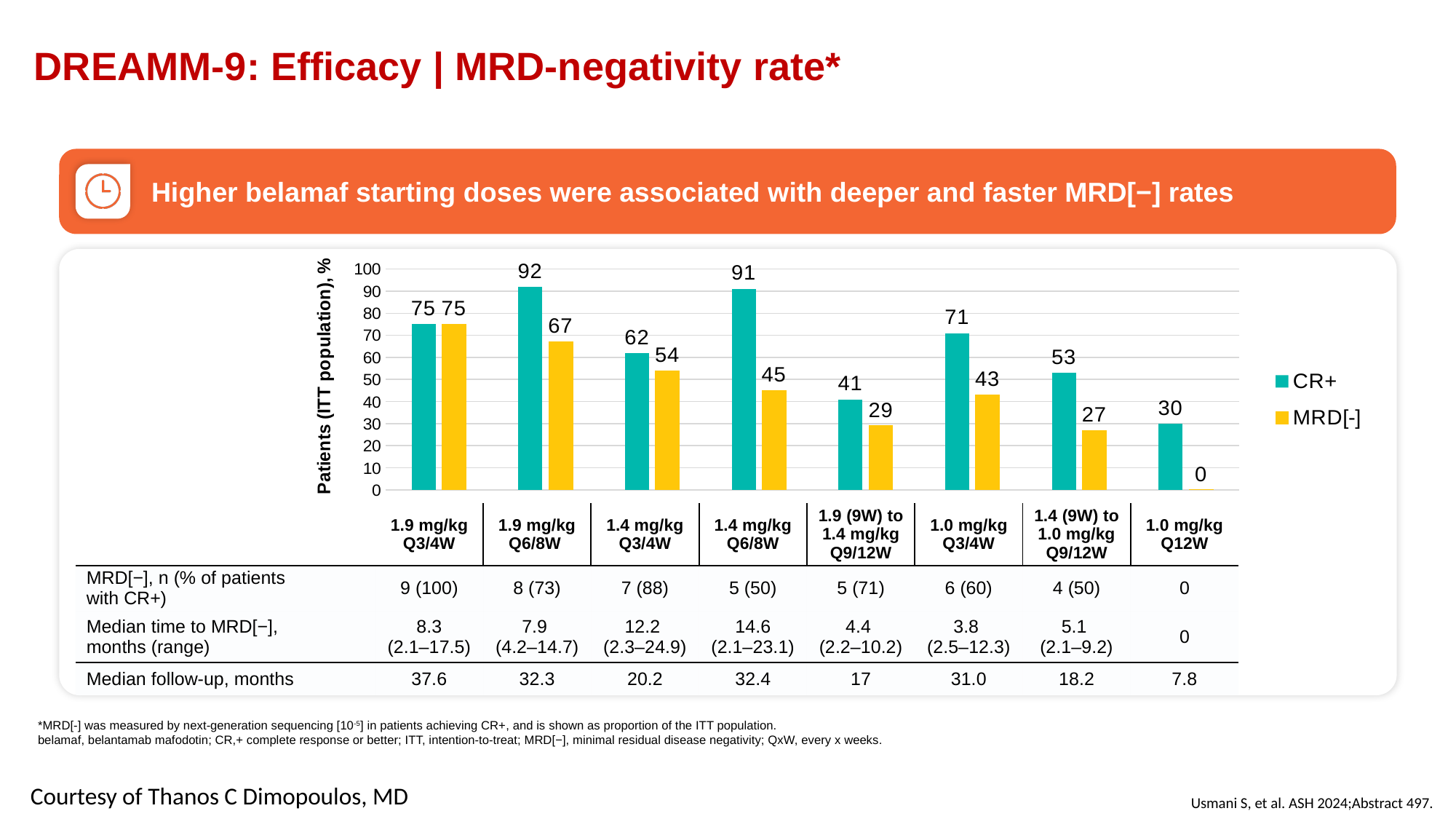
Which dose group has the lowest MRD[-] value? 1.0 mg/kg Q12W Which dose group has the highest CR+ value? 1.9 mg/kg Q6/8W What is the difference between the CR+ and MRD[-] values for the 1.4 mg/kg Q6/8W group? 46 How many dose groups are shown on the x axis of the chart? 8 What is the CR+ value for the 1.9 mg/kg Q6/8W group? 92 What is the MRD[-] value for the 1.4 mg/kg Q3/4W group? 54 What is the label of the y axis of the chart? Patients (ITT population), % What is the MRD[-] value for the 1.0 mg/kg Q12W group? 0 Is the CR+ value for the 1.9 (9W) to 1.4 mg/kg Q9/12W group greater or less than 50? less How many series does the chart legend list? 2 Which is larger, the MRD[-] value for 1.9 mg/kg Q3/4W or for 1.0 mg/kg Q3/4W? 1.9 mg/kg Q3/4W What kind of chart is shown on the slide? bar chart